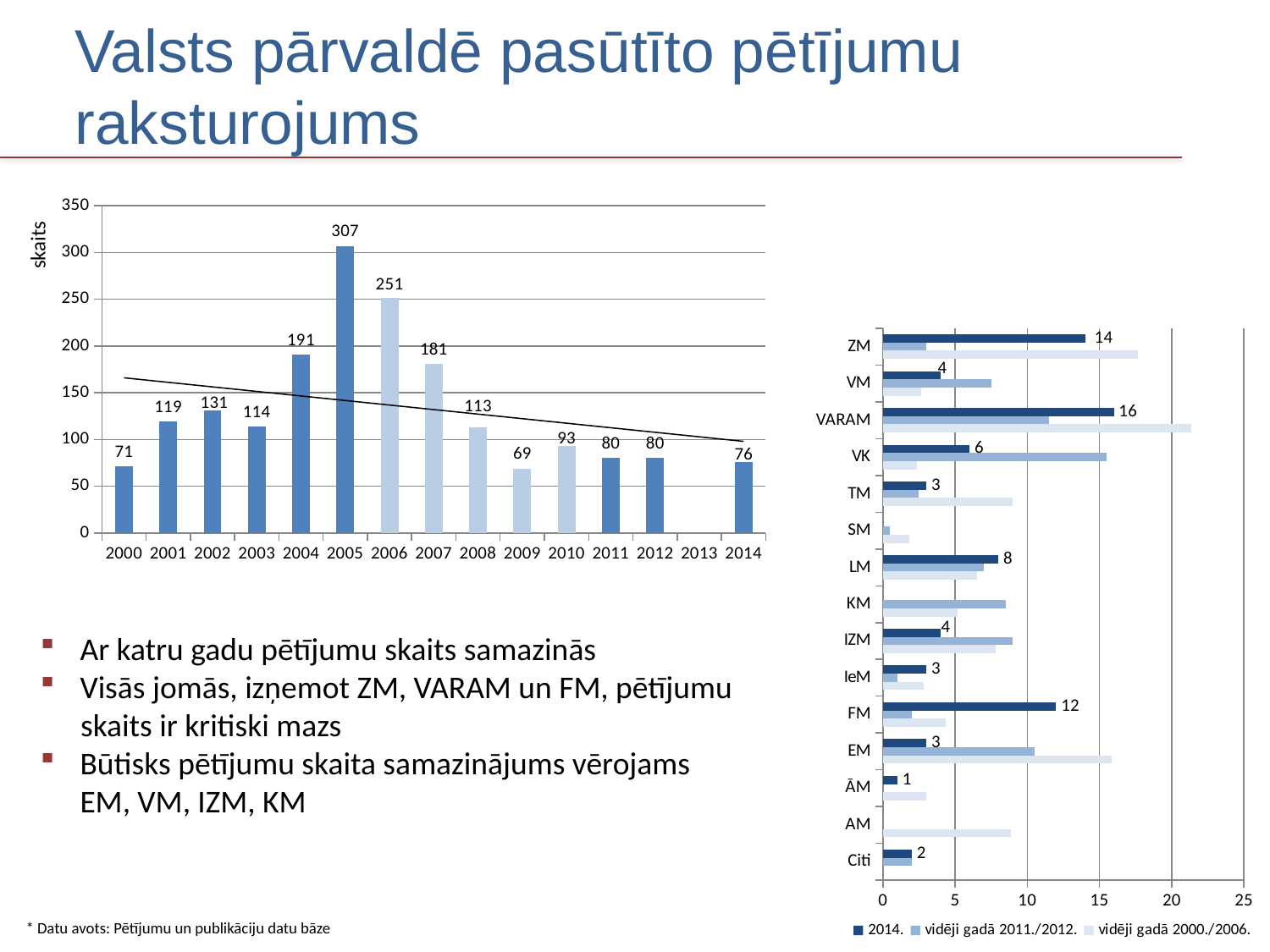
In the right chart, what is the 2014 value for FM? 12 In the right chart, is the 'vidēji gadā 2000./2006.' value for VARAM greater or less than 20? greater In the left chart, what is the difference between the values for 2005 and 2006? 56 In the right chart, what is the 2014 value for VARAM? 16 How many series does the legend of the right chart list? 3 In the left chart, which year has the lowest value? 2009 What kind of chart is the left chart? bar chart In the left chart, which year has the highest value? 2005 In the left chart, what is the value for 2005? 307 In the left chart, which is larger, the value for 2004 or the value for 2007? 2004 In the left chart, what is the value for 2000? 71 In the right chart, which category has the highest 2014 value? VARAM